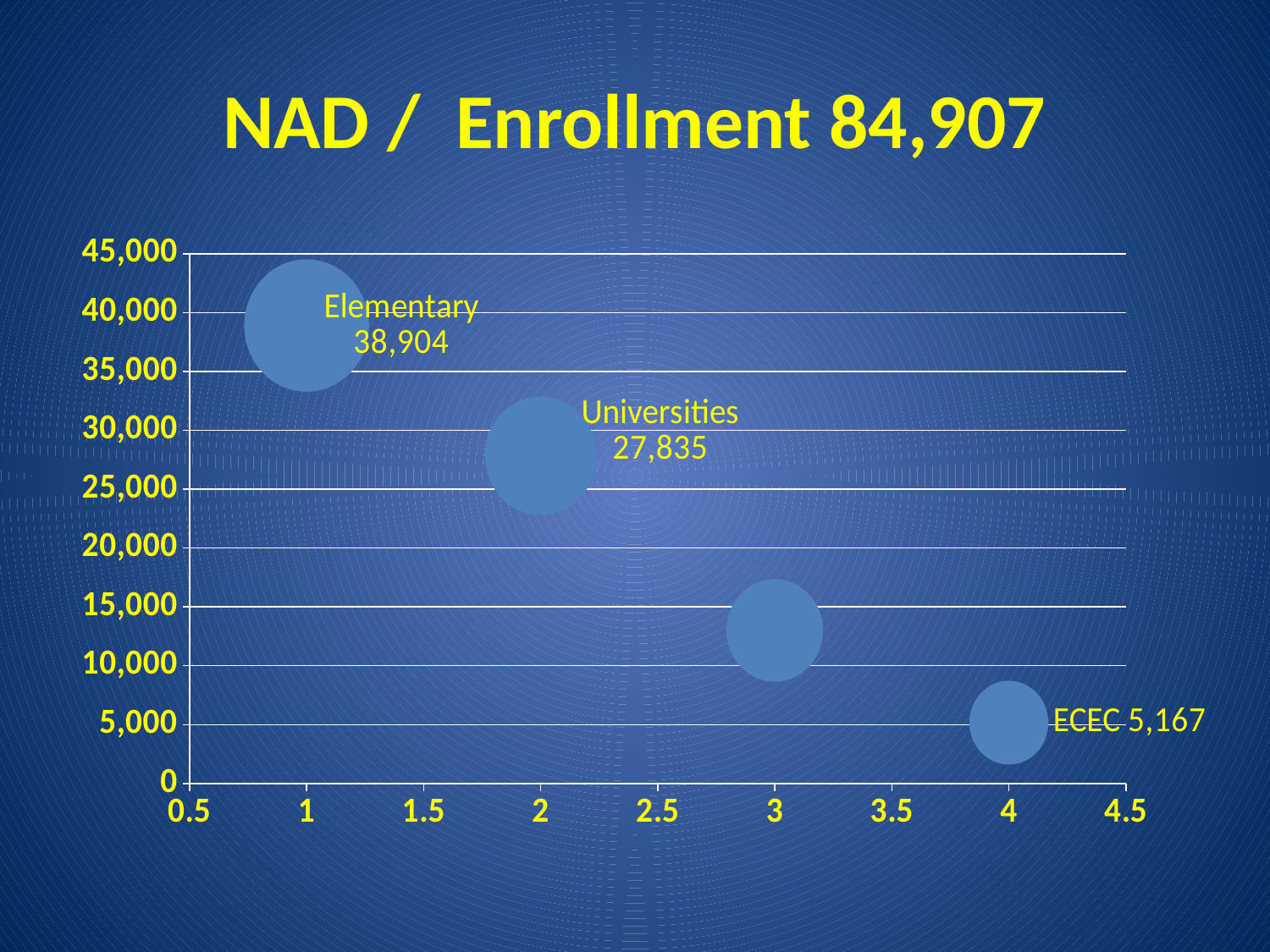
Which is larger, the enrollment for Universities or for ECEC? Universities Which labeled category has the lowest enrollment? ECEC What is the difference between the Elementary and Universities enrollment values? 11,069 What kind of chart is shown on the slide? Bubble chart What is the title of the slide? NAD / Enrollment 84,907 What is the difference between the Universities and ECEC enrollment values? 22,668 Is the value of the unlabeled bubble at x = 3 greater or less than 10,000? greater What is the enrollment value shown for ECEC? 5,167 What is the enrollment value shown for Universities? 27,835 What is the enrollment value shown for Elementary? 38,904 How many bubbles are plotted on the chart? 4 Which labeled category has the highest enrollment? Elementary